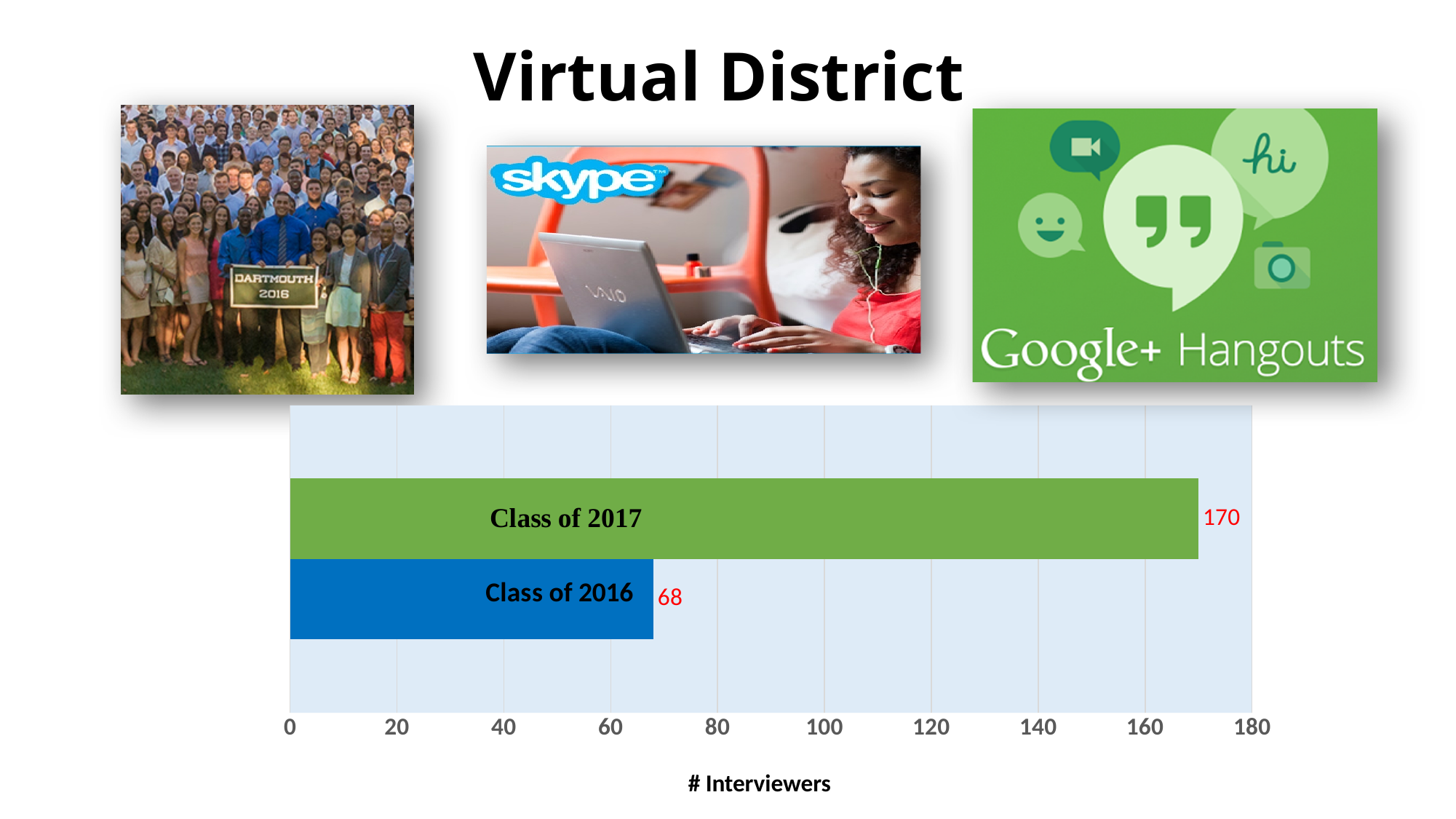
Which class has the lower number of interviewers? Class of 2016 Which class has the higher number of interviewers? Class of 2017 Is the value for the Class of 2017 greater or less than 160? greater What is the highest value shown on the horizontal axis of the chart? 180 Is the value for the Class of 2016 greater or less than 80? less Is the number of interviewers larger for the Class of 2016 or the Class of 2017? Class of 2017 What is the difference in the number of interviewers between the Class of 2017 and the Class of 2016? 102 What is the number of interviewers for the Class of 2016? 68 What kind of chart is shown on the slide? bar chart What is the number of interviewers for the Class of 2017? 170 What is the label on the horizontal axis of the chart? # Interviewers How many classes are shown in the chart? 2